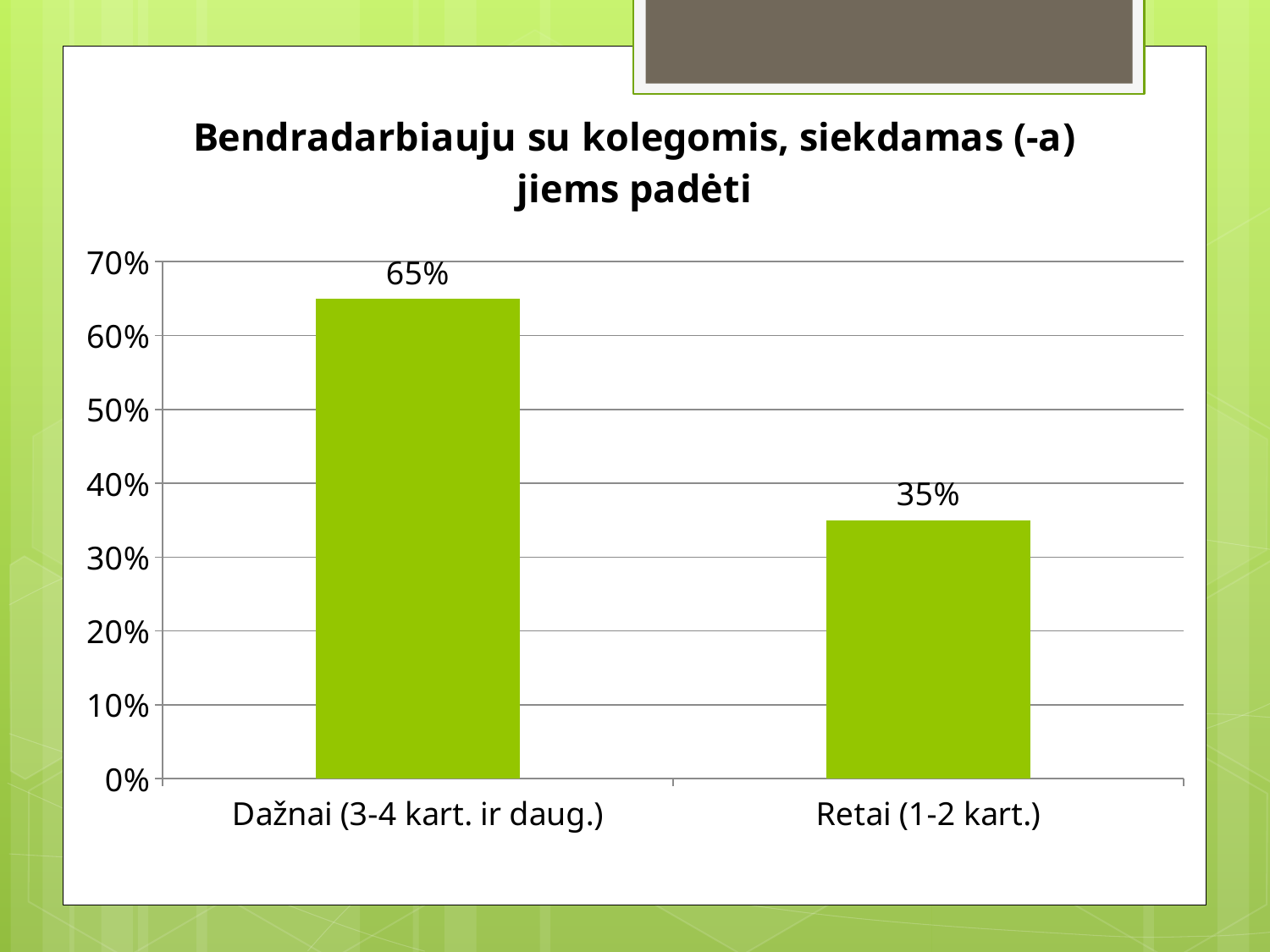
Is the value for "Retai (1-2 kart.)" greater or less than 40%? less Which category has the highest value? Dažnai (3-4 kart. ir daug.) How many categories are shown on the chart? 2 What is the highest value shown on the vertical axis? 70% Which is larger, the value for "Dažnai (3-4 kart. ir daug.)" or for "Retai (1-2 kart.)"? Dažnai (3-4 kart. ir daug.) Which category has the lowest value? Retai (1-2 kart.) What kind of chart is shown on the slide? bar chart What is the value for "Dažnai (3-4 kart. ir daug.)"? 65% What is the difference between the values for "Dažnai (3-4 kart. ir daug.)" and "Retai (1-2 kart.)"? 30% Is the value for "Dažnai (3-4 kart. ir daug.)" greater or less than 60%? greater What is the title of the chart? Bendradarbiauju su kolegomis, siekdamas (-a) jiems padėti What is the value for "Retai (1-2 kart.)"? 35%